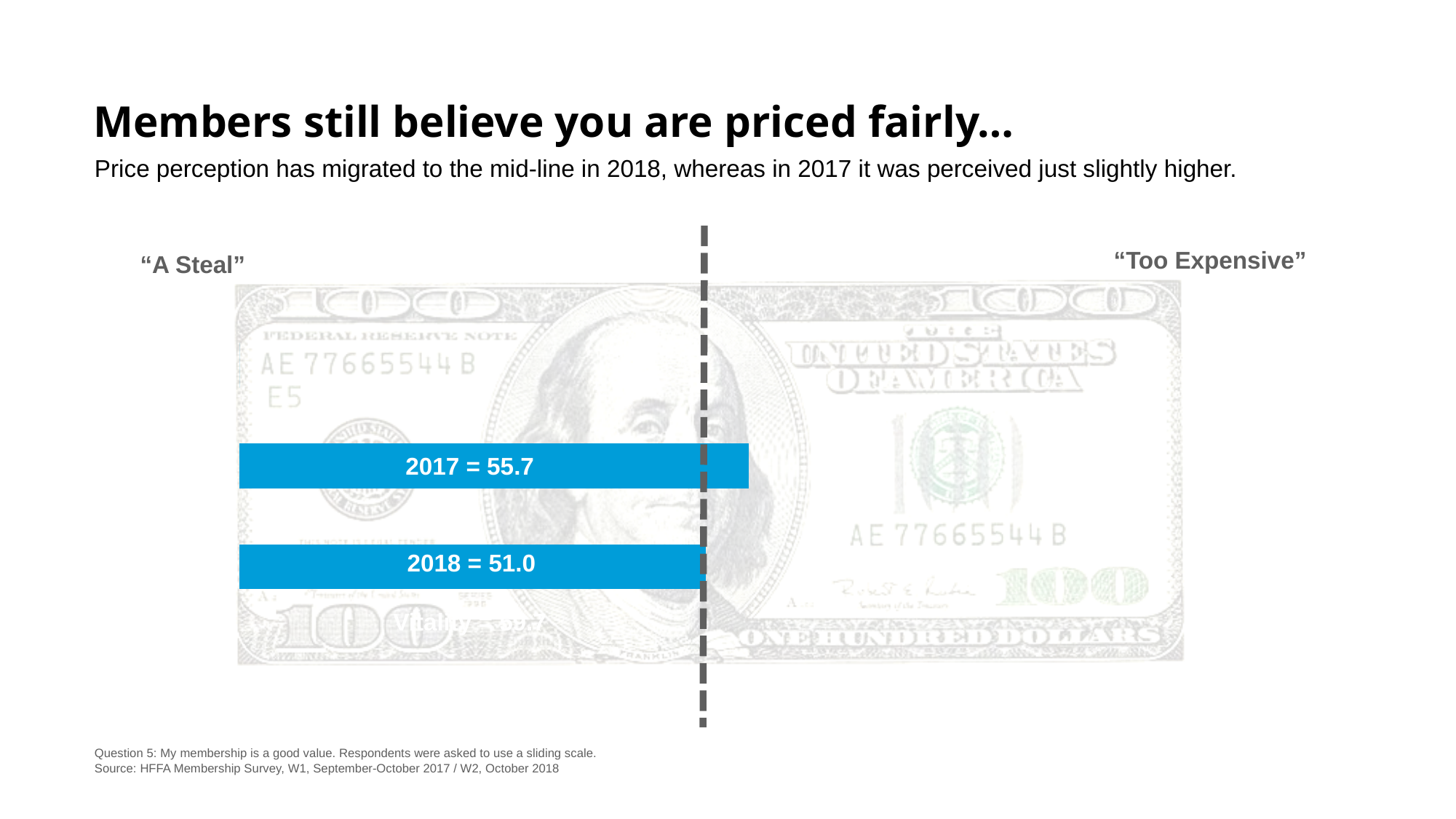
How many bars are plotted on the chart? 2 What label appears at the right end of the scale? "Too Expensive" What kind of chart is shown on the slide? bar chart What is the difference between the 2017 value and the 2018 value? 4.7 What is the value shown for 2018? 51.0 What label appears at the left end of the scale? "A Steal" Which year has the higher value, 2017 or 2018? 2017 Did the value rise or fall from 2017 to 2018? fall What is the value shown for 2017? 55.7 Which year has the lower value? 2018 Is the value for 2018 larger or smaller than the value for 2017? smaller